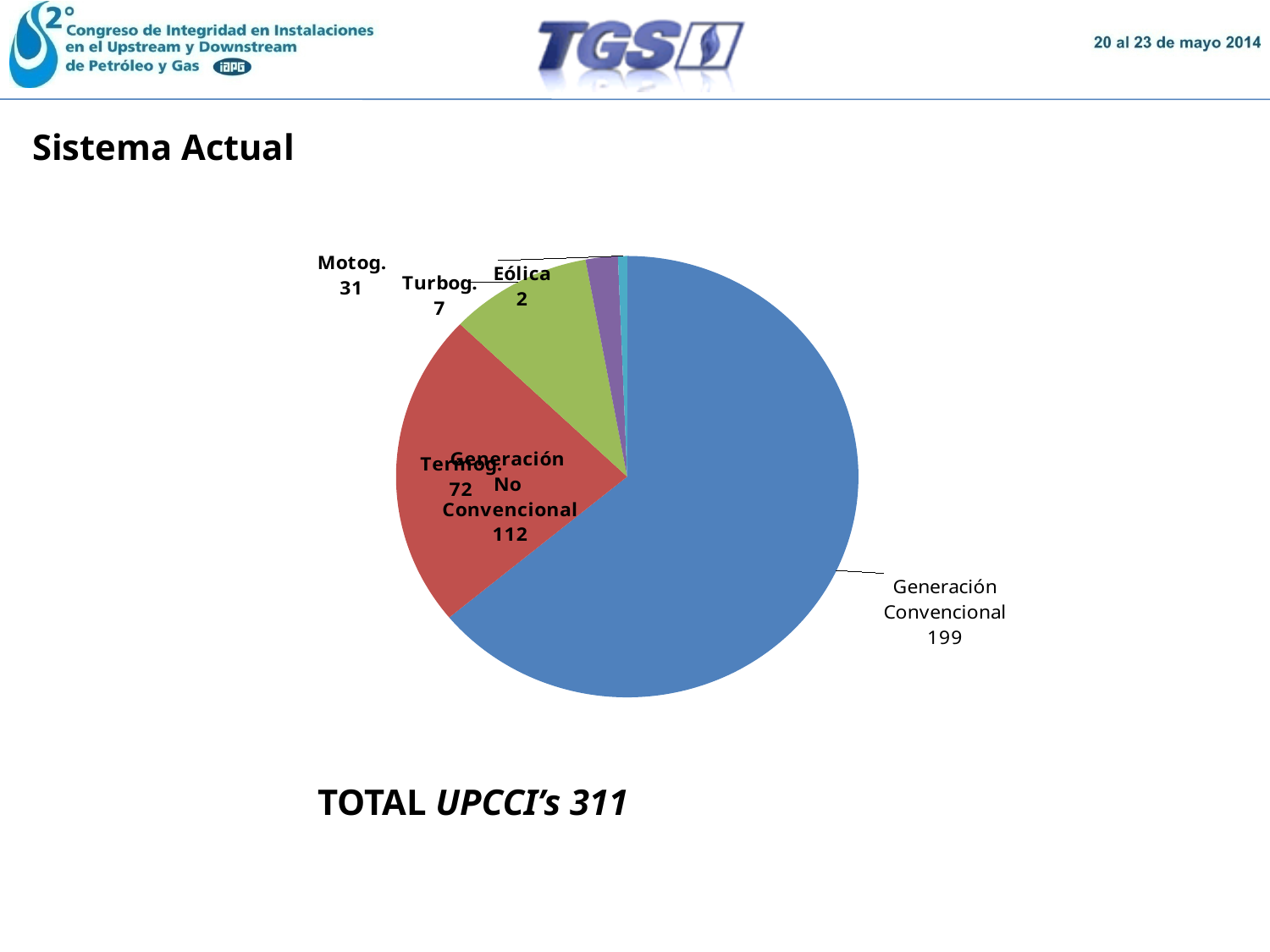
Which is larger, the value for Motog. or the value for Turbog.? Motog. Which category has the smallest slice in the pie chart? Eólica What is the value for Turbog. in the pie chart? 7 What kind of chart is shown on the slide? Pie chart What total of UPCCI's is stated below the chart? 311 What is the difference between the values for Termog. and Turbog.? 65 Which category has the largest slice in the pie chart? Generación Convencional What is the value for Motog. in the pie chart? 31 What is the value for Generación Convencional in the pie chart? 199 What is the value for Termog. in the pie chart? 72 What is the value for Eólica in the pie chart? 2 What is the difference between the values for Generación Convencional and Motog.? 168